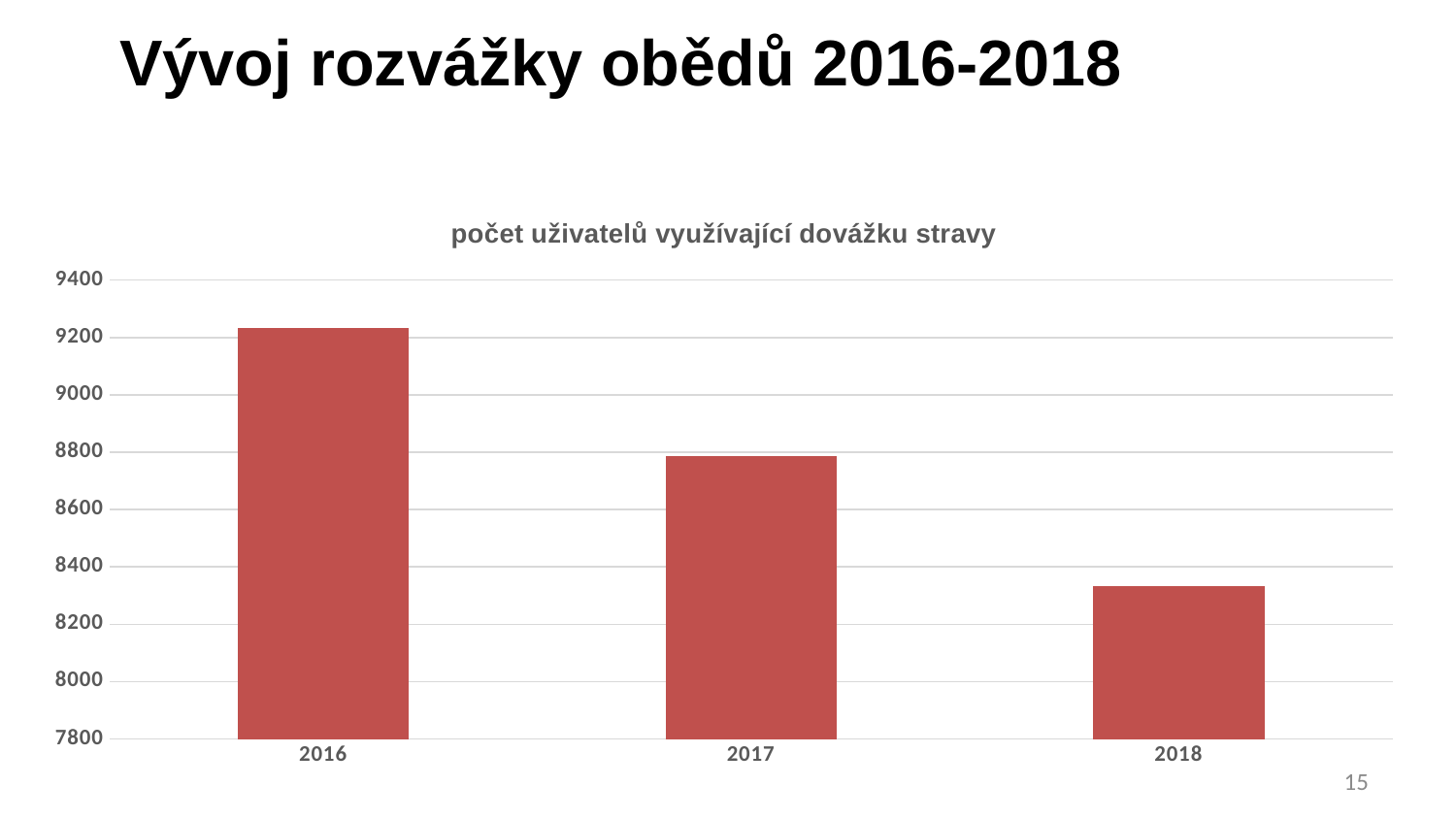
What colour are the bars in the chart? red Which year has the lowest number of users using food delivery? 2018 Which year has the highest number of users using food delivery? 2016 How many years are shown on the x axis of the chart? 3 Is the value for 2018 greater or less than 8400? less What kind of chart is shown on the slide? bar chart Is the value for 2017 greater or less than 9000? less Is the value for 2016 greater or less than 9000? greater Do the values rise or fall from 2016 to 2018? fall Which is larger, the value for 2016 or the value for 2017? 2016 What is the title of the chart? počet uživatelů využívající dovážku stravy